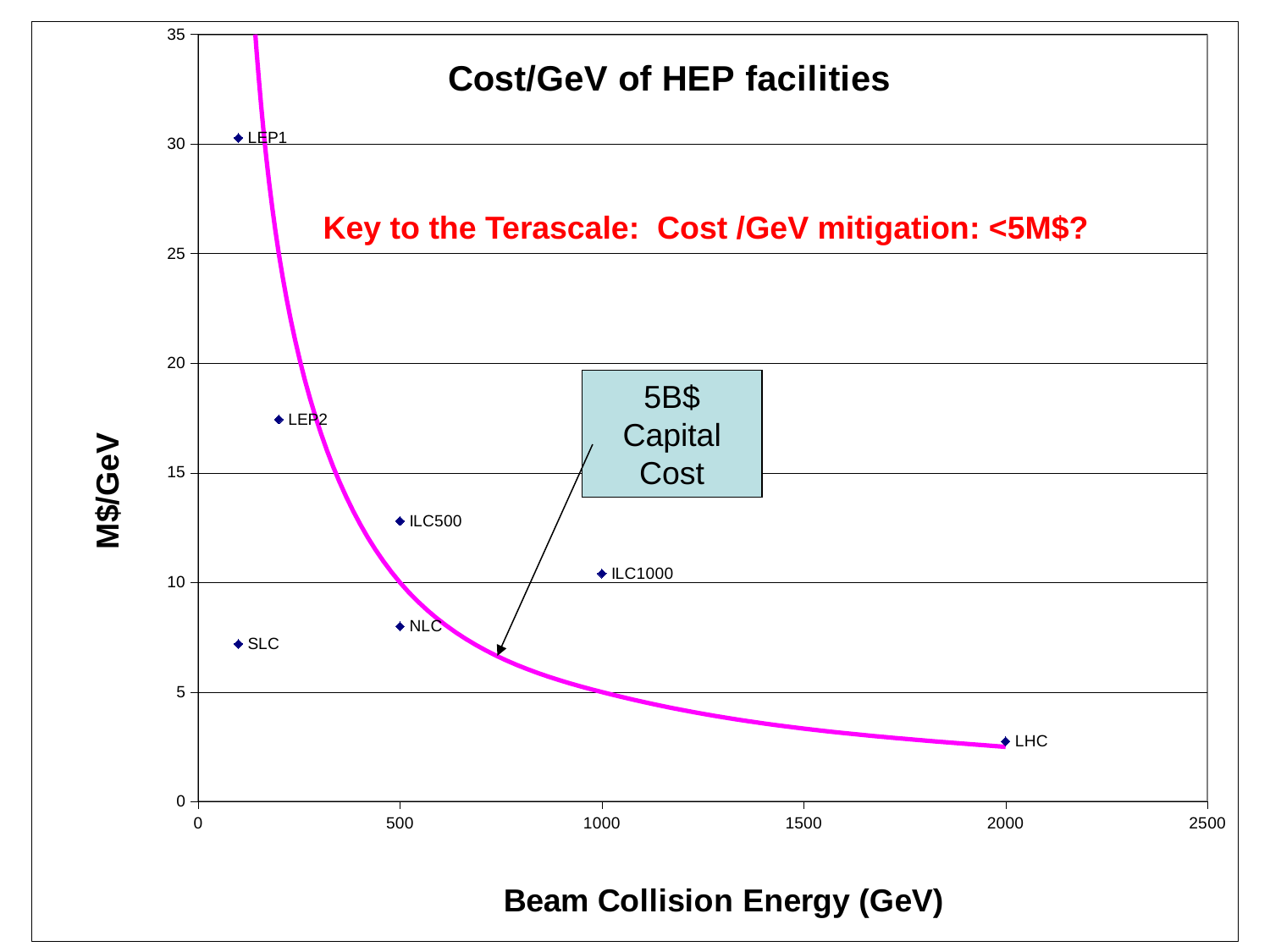
Is the M$/GeV value for SLC greater or less than 10? less What is the title of the chart? Cost/GeV of HEP facilities What kind of chart is shown on the slide? scatter chart Which has a higher M$/GeV value, NLC or ILC1000? ILC1000 How many labeled data points are plotted on the chart? 7 Which facility has the highest cost per GeV (M$/GeV)? LEP1 Which has a higher M$/GeV value, LEP2 or ILC500? LEP2 Is the M$/GeV value for LHC greater or less than 5? less Is the M$/GeV value for LEP1 greater or less than 25? greater Which facility has the lowest cost per GeV (M$/GeV)? LHC Does the fitted curve rise or fall as beam collision energy increases? fall